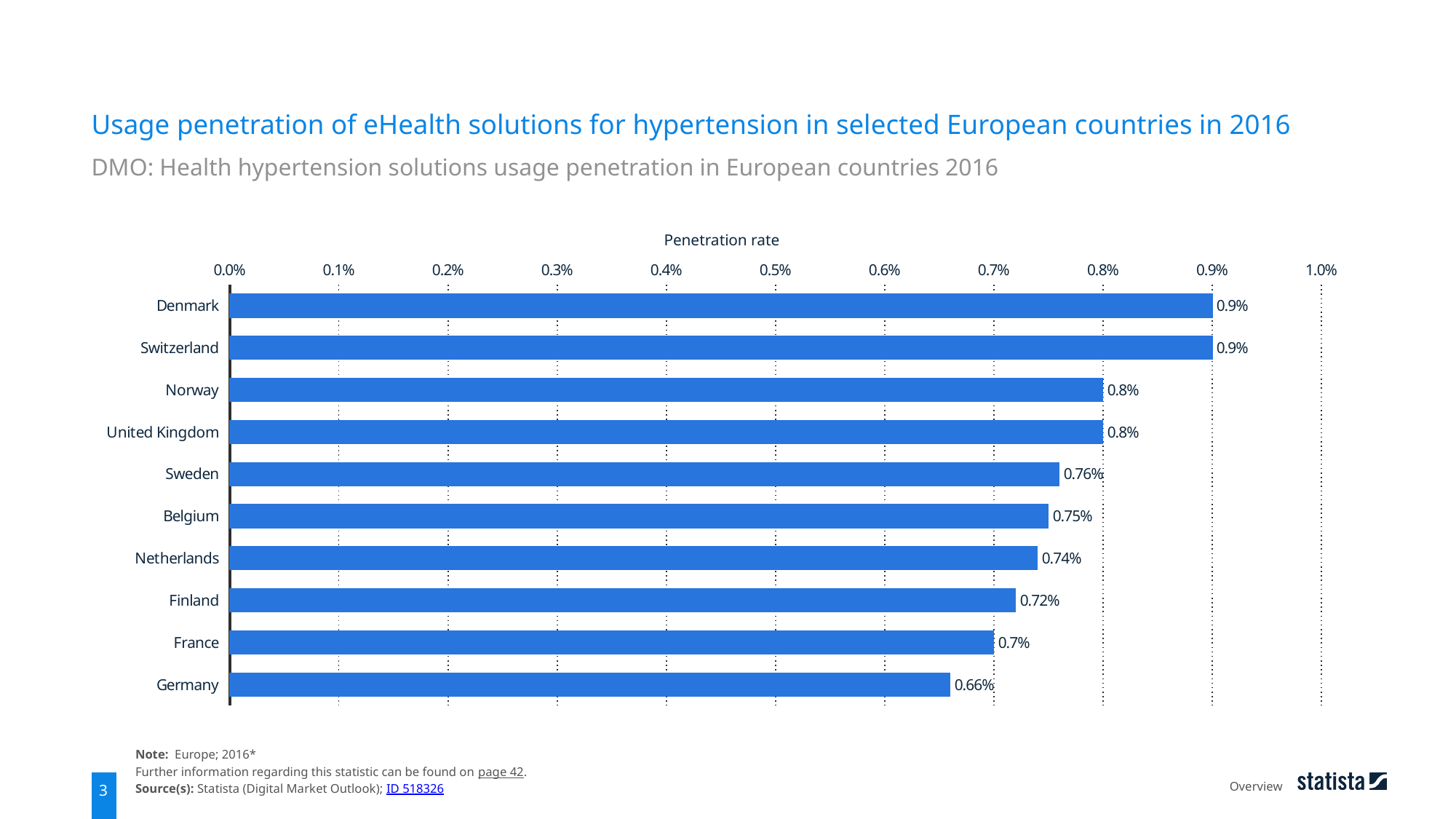
What type of chart is shown on the slide? Bar chart What is the difference between the penetration rates of Belgium and Finland? 0.03% What is the label of the value axis? Penetration rate What is the difference between the penetration rates of Sweden and Germany? 0.1% What is the penetration rate for Sweden? 0.76% How many countries are shown in the chart? 10 What is the penetration rate for Netherlands? 0.74% Which has a higher penetration rate, Norway or France? Norway What is the penetration rate for Finland? 0.72% Which has a higher penetration rate, Germany or Belgium? Belgium What is the penetration rate for Germany? 0.66% Which country has the lowest penetration rate? Germany